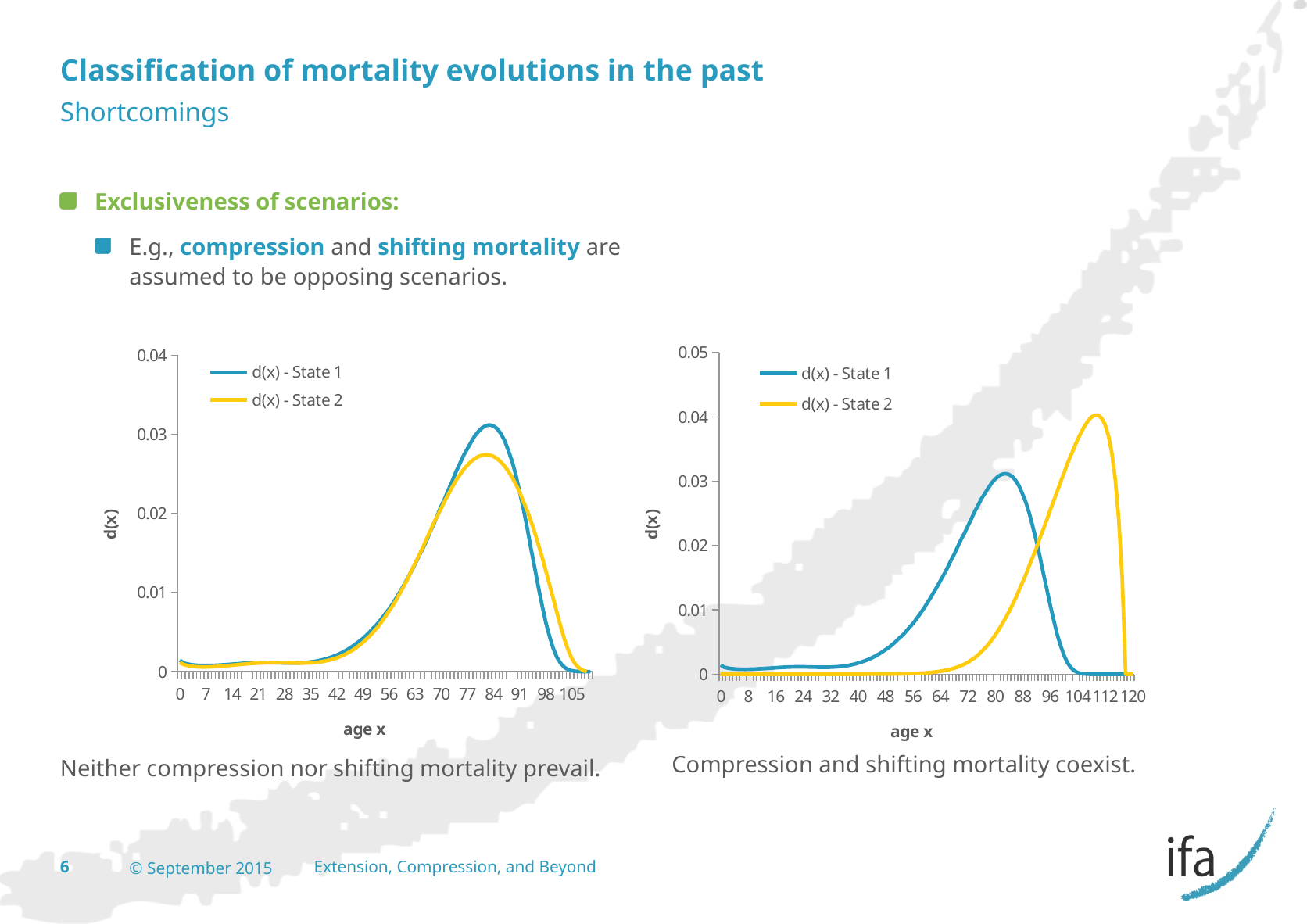
What is the label of the x axis in the left chart? age x In the left chart, does d(x) - State 1 rise or fall between age 56 and age 77? rise In the left chart, is the peak value of d(x) - State 2 greater or less than 0.03? less What is the highest tick value on the y axis of the right chart? 0.05 In the right chart, is the peak value of d(x) - State 1 greater or less than 0.04? less What kind of chart is the left chart? line chart In the left chart, which series reaches the higher peak, d(x) - State 1 or d(x) - State 2? d(x) - State 1 In the right chart, is the peak value of d(x) - State 2 greater or less than 0.03? greater In the right chart, which series reaches the higher peak, d(x) - State 1 or d(x) - State 2? d(x) - State 2 How many series does the legend of the right chart list? 2 In the right chart, does d(x) - State 1 rise or fall between age 88 and age 104? fall